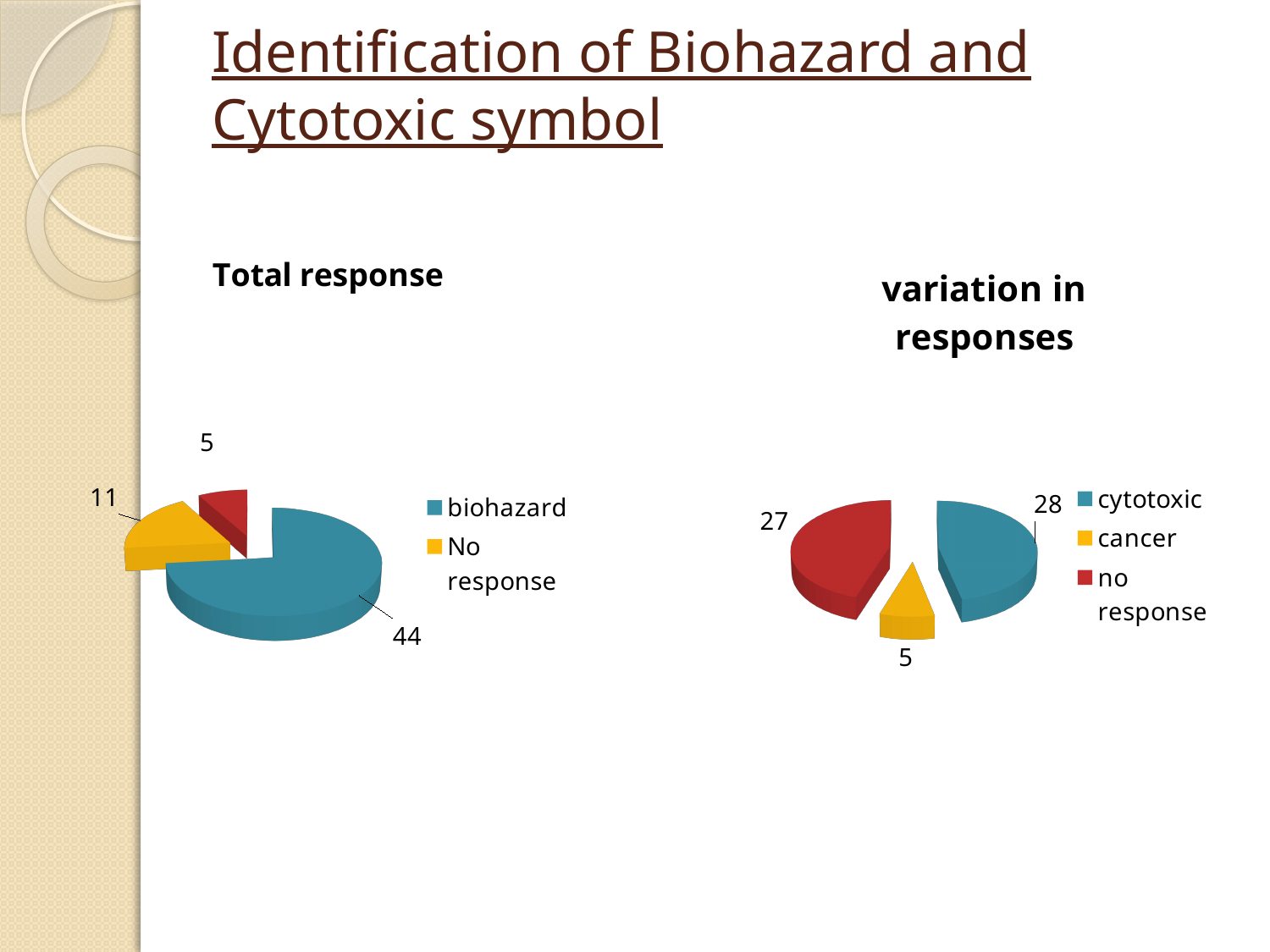
In the "Total response" chart, what is the difference between the biohazard value and the No response value? 33 In the "Total response" chart, what is the value for No response? 11 What kind of chart is the "Total response" chart? pie chart In the "variation in responses" chart, what is the difference between the cytotoxic value and the cancer value? 23 How many categories does the "variation in responses" chart show? 3 In the "Total response" chart, which category has the largest slice? biohazard In the "variation in responses" chart, what is the value for cytotoxic? 28 How many entries does the legend of the "Total response" chart list? 2 In the "Total response" chart, what is the value for biohazard? 44 In the "variation in responses" chart, what is the value for no response? 27 In the "variation in responses" chart, what is the value for cancer? 5 In the "variation in responses" chart, which category has the smallest slice? cancer